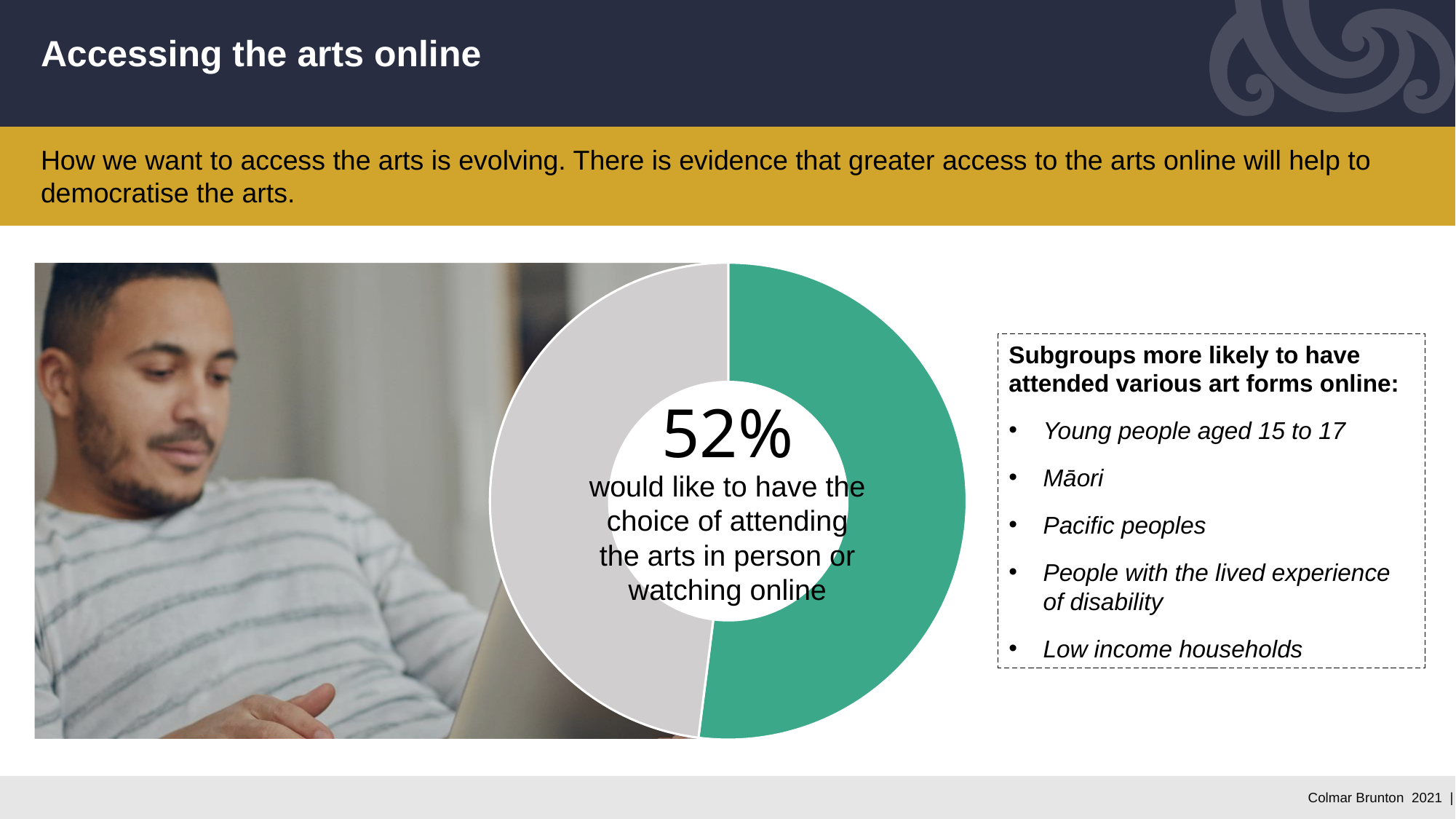
Which segment of the donut chart is larger, the green one or the grey one? The green one What colour is the segment representing the 52% who would like the choice of attending in person or watching online? Green What share of the donut chart does the green segment represent? 52% What is the title of the slide containing the donut chart? Accessing the arts online How many segments does the donut chart have? 2 Is the value shown in the centre of the donut chart greater or less than 50%? greater What kind of chart is shown on the slide? Donut (pie) chart What percentage of people would like to have the choice of attending the arts in person or watching online? 52%